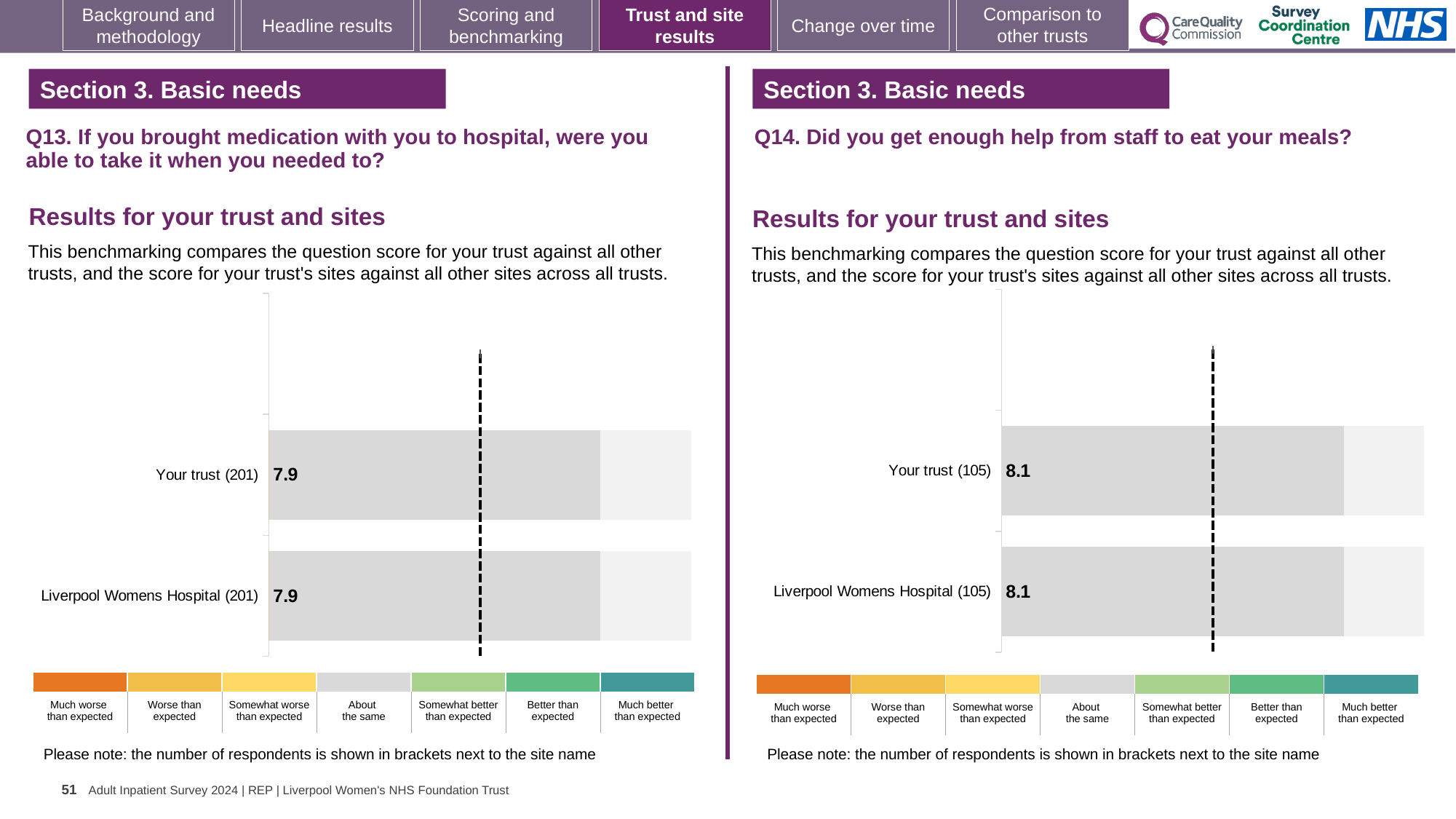
How many bars are plotted in the Q13 chart on the left? 2 In the Q13 chart on the left, how many respondents are shown in brackets next to Your trust? 201 In the Q14 chart on the right, how many respondents are shown in brackets next to Liverpool Womens Hospital? 105 What kind of chart is the Q13 chart on the left? Bar chart In the Q13 chart on the left, what is the score for Your trust (201)? 7.9 In the Q13 chart on the left, what is the difference between the score for Your trust and the score for Liverpool Womens Hospital? 0 How many bars are plotted in the Q14 chart on the right? 2 In the Q14 chart on the right, what is the score for Your trust (105)? 8.1 In the Q13 chart on the left, what is the score for Liverpool Womens Hospital (201)? 7.9 In the Q14 chart on the right, what is the score for Liverpool Womens Hospital (105)? 8.1 In the Q14 chart on the right, what is the difference between the score for Your trust and the score for Liverpool Womens Hospital? 0